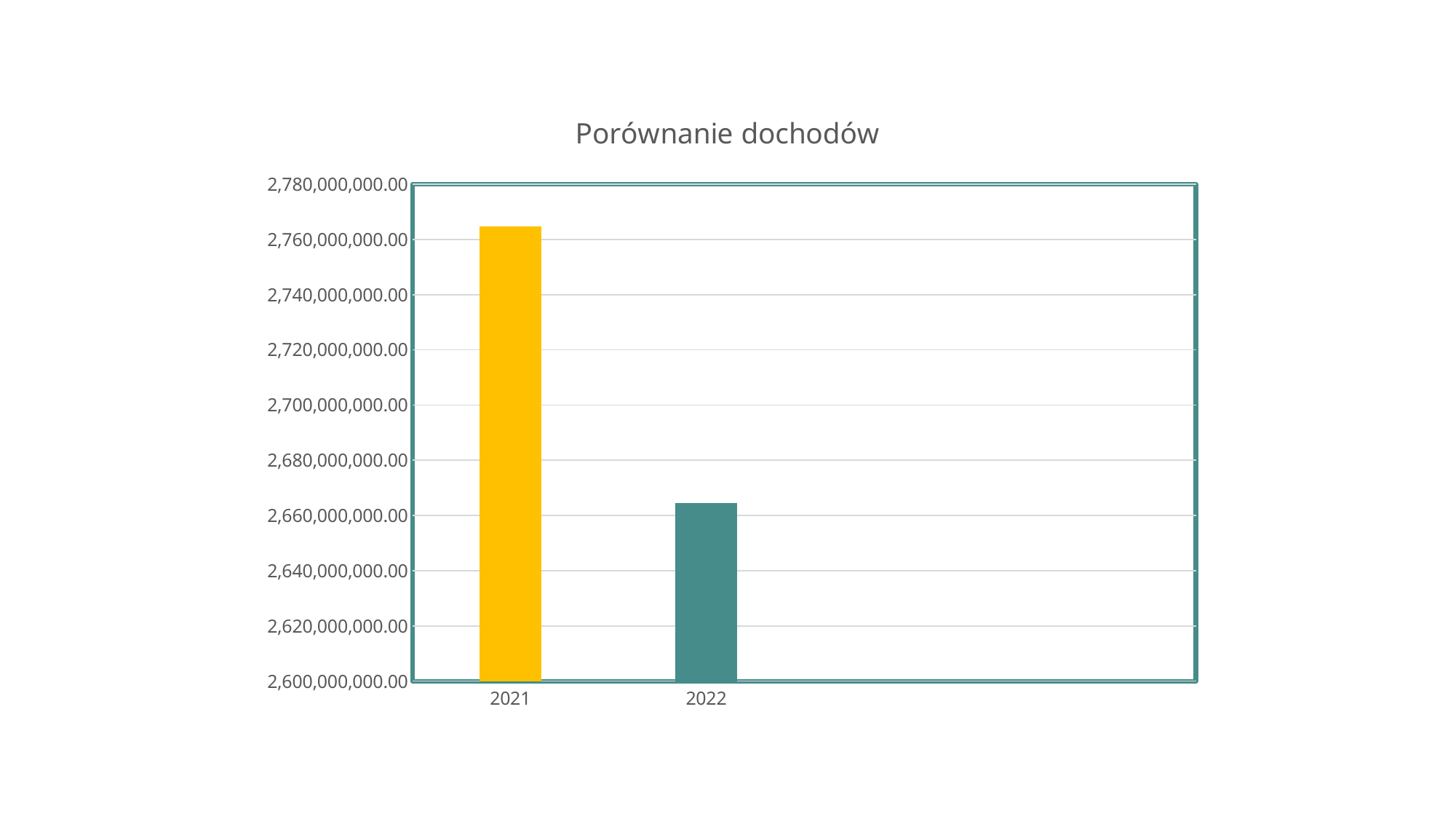
Which is larger, the value for 2021 or the value for 2022? 2021 Is the value for 2022 greater or less than 2,680,000,000.00? less Which year has the lowest value? 2022 What colour is the bar for 2021? yellow Is the value for 2022 greater or less than 2,660,000,000.00? greater Is the value for 2021 greater or less than 2,760,000,000.00? greater What is the title of the chart? Porównanie dochodów How many categories are shown on the x axis? 2 Which year has the highest value? 2021 What kind of chart is shown on the slide? bar chart Do the values rise or fall from 2021 to 2022? fall